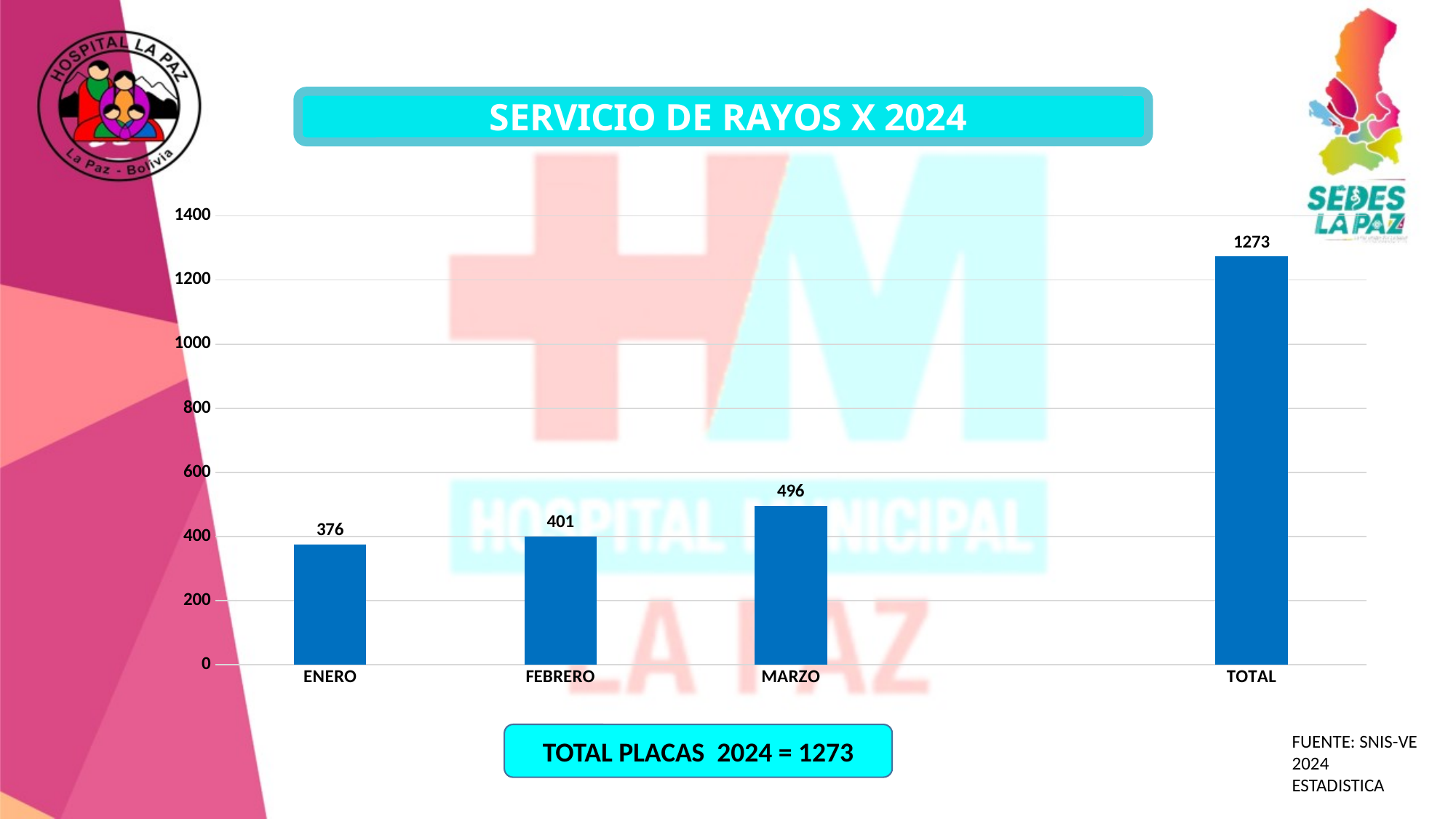
What is the value for ENERO? 376 How many bars are shown in the chart? 4 Which of the three months (ENERO, FEBRERO, MARZO) has the highest value? MARZO What is the difference between the values for MARZO and ENERO? 120 Is the value for MARZO greater or less than 400? greater Which is larger, the value for FEBRERO or the value for ENERO? FEBRERO Which category has the lowest value? ENERO What is the value for FEBRERO? 401 What is the title of the chart? SERVICIO DE RAYOS X 2024 What is the value for TOTAL? 1273 What is the value for MARZO? 496 What kind of chart is shown on the slide? bar chart